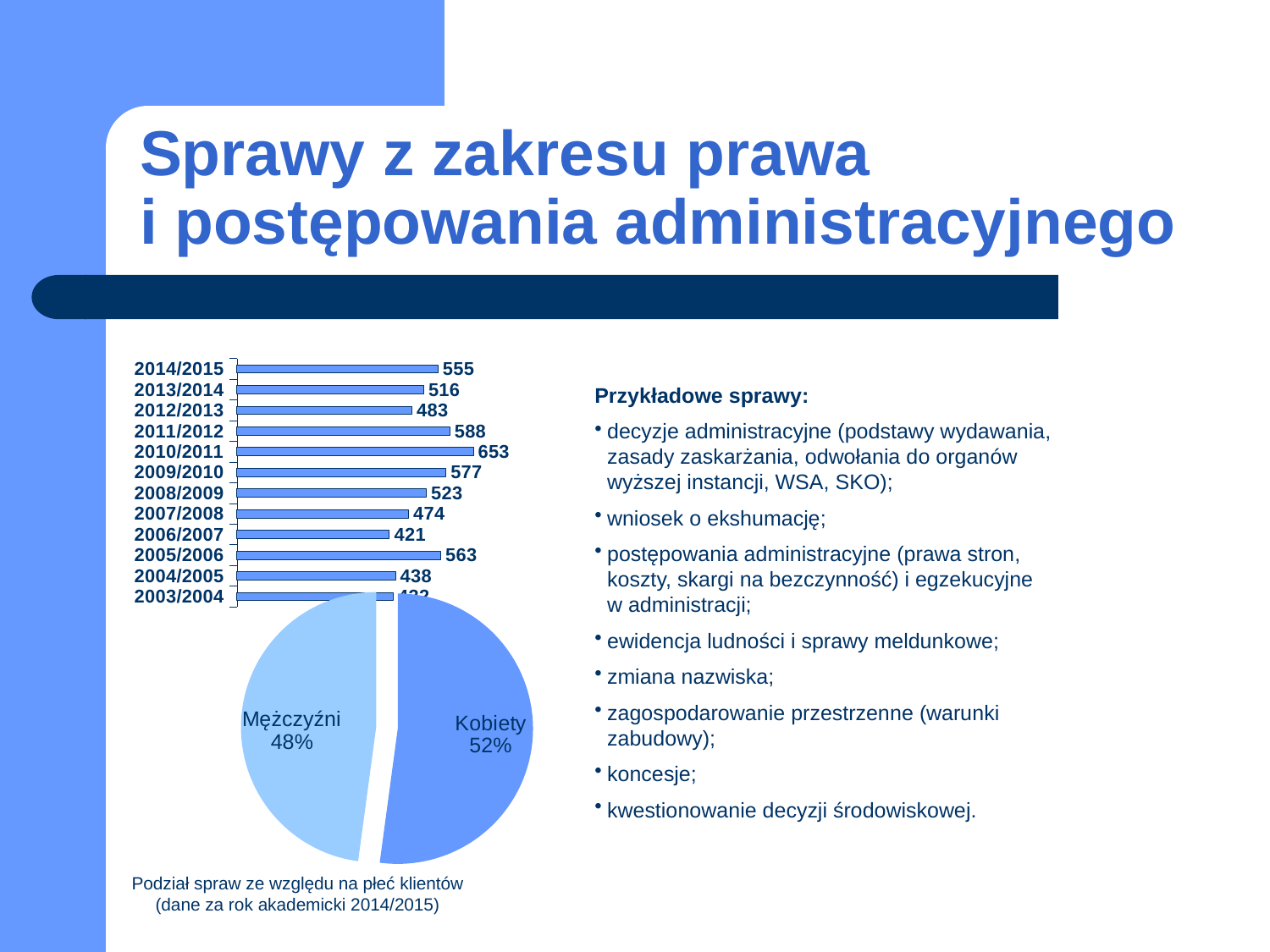
In the bar chart, what is the value for 2006/2007? 421 What kind of chart is the chart showing values by academic year? bar chart In the bar chart, what is the difference between the values for 2011/2012 and 2012/2013? 105 In the bar chart, which is larger: the value for 2005/2006 or the value for 2013/2014? 2005/2006 In the bar chart, what is the value for 2010/2011? 653 How many academic years are shown in the bar chart? 12 In the bar chart, what is the value for 2014/2015? 555 In the bar chart, what is the difference between the values for 2014/2015 and 2004/2005? 117 In the pie chart, what share is labelled for Mężczyźni? 48% In the bar chart, which academic year has the highest value? 2010/2011 What is the caption below the pie chart? Podział spraw ze względu na płeć klientów (dane za rok akademicki 2014/2015) In the pie chart, what share is labelled for Kobiety? 52%